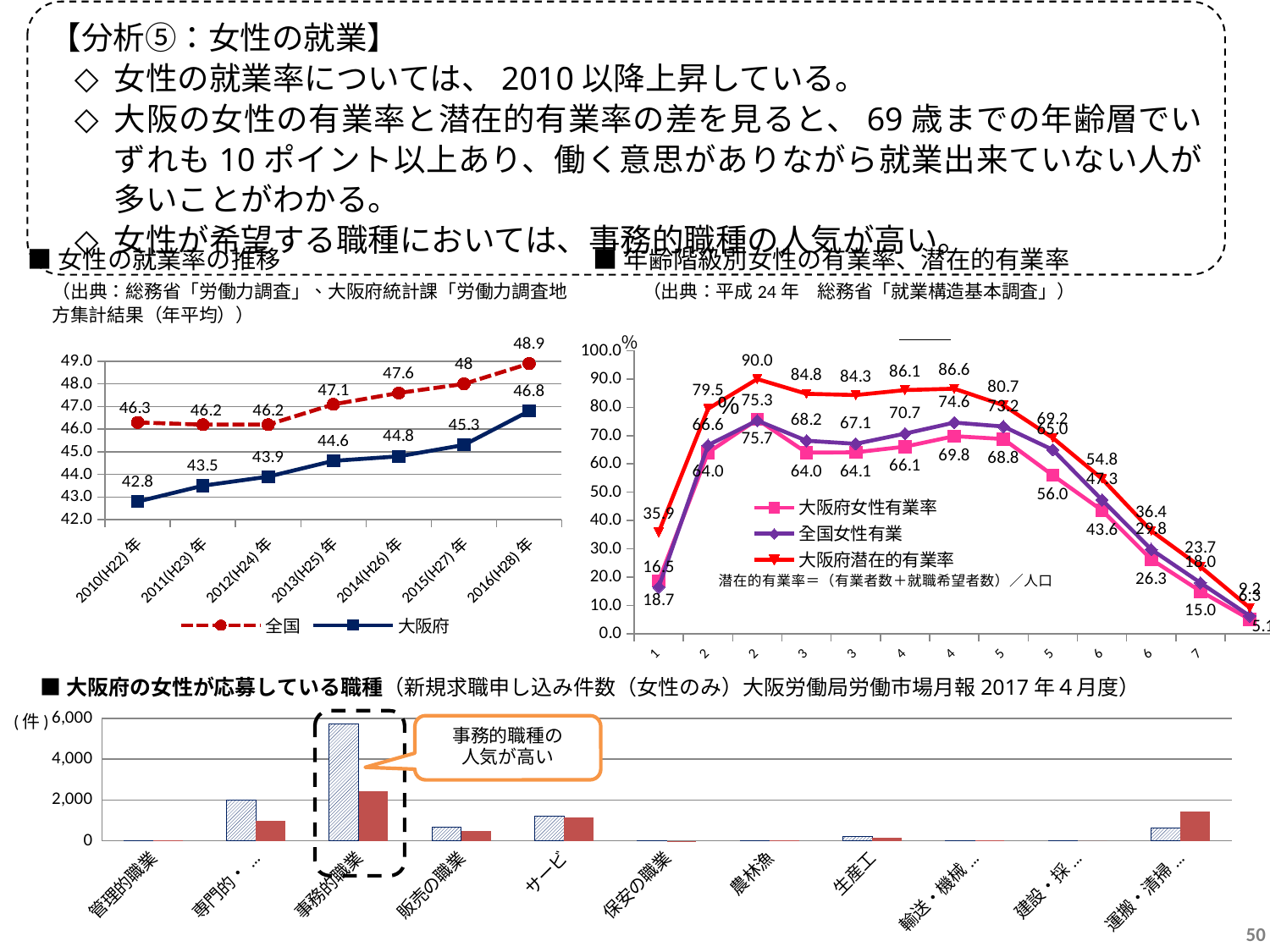
In the chart titled 年齢階級別女性の有業率、潜在的有業率, what is the highest value of the 大阪府潜在的有業率 series? 90.0 In the chart titled 年齢階級別女性の有業率、潜在的有業率, how many series does the legend list? 3 In the bottom chart titled 大阪府の女性が応募している職種, which category has the highest bar? 事務的職業 In the chart titled 女性の就業率の推移, what is the value for 大阪府 in 2010(H22)年? 42.8 In the bottom chart titled 大阪府の女性が応募している職種, is the value of the hatched bar for 事務的職業 greater or less than 4,000? greater In the chart titled 女性の就業率の推移, which year has the lowest value for 大阪府? 2010(H22)年 In the chart titled 女性の就業率の推移, what is the value for 全国 in 2016(H28)年? 48.9 In the chart titled 女性の就業率の推移, does the 大阪府 series rise or fall from 2010(H22)年 to 2016(H28)年? rise In the chart titled 女性の就業率の推移, how many series does the legend list? 2 In the bottom chart titled 大阪府の女性が応募している職種, what kind of chart is it? bar chart In the chart titled 年齢階級別女性の有業率、潜在的有業率, what kind of chart is it? line chart In the chart titled 女性の就業率の推移, what is the difference between 全国 and 大阪府 in 2013(H25)年? 2.5